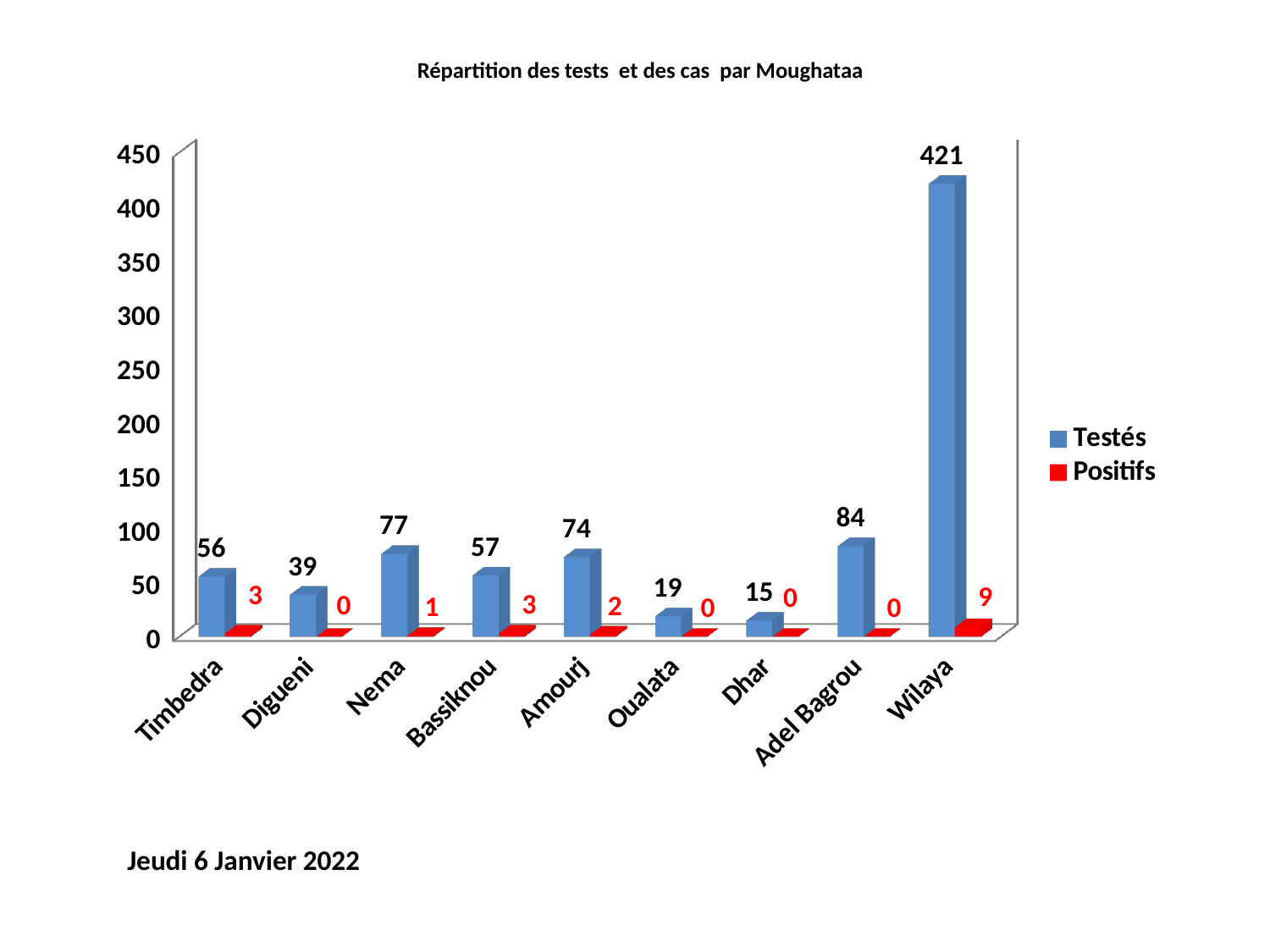
Which category has the lowest Testés value? Dhar What kind of chart is shown on the slide? bar chart What is the Testés value for Adel Bagrou? 84 Which category has the highest Testés value? Wilaya Which has a larger Testés value, Timbedra or Amourj? Amourj What is the Testés value for Nema? 77 How many series does the legend list? 2 Is the Testés value for Wilaya greater or less than 400? greater What is the difference between the Testés values for Nema and Digueni? 38 How many categories are shown on the x axis? 9 What is the Positifs value for Wilaya? 9 What is the title of the chart? Répartition des tests et des cas par Moughataa